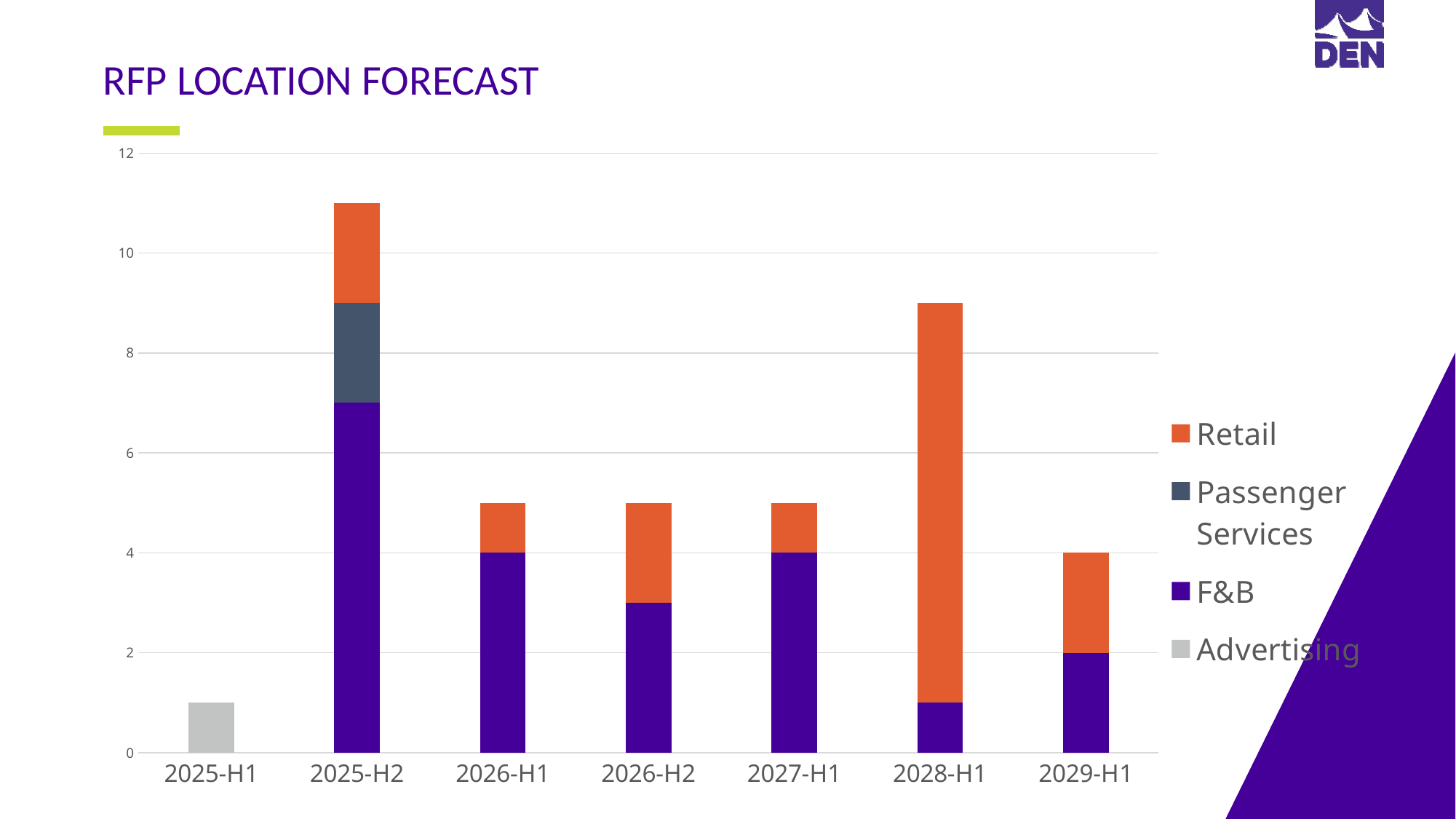
What is the F&B value for 2029-H1? 2 What is the F&B value for 2026-H1? 4 What kind of chart is shown on the slide? Stacked bar chart What is the total height of the stacked bar for 2029-H1? 4 What is the title of the chart? RFP LOCATION FORECAST Which period has the tallest stacked bar? 2025-H2 How many periods are shown on the x axis? 7 Which period has the shortest stacked bar? 2025-H1 Which has the larger total, 2028-H1 or 2026-H2? 2028-H1 Is the total for 2025-H2 greater or less than 10? greater Is the total for 2028-H1 greater or less than 8? greater How many series does the legend list? 4